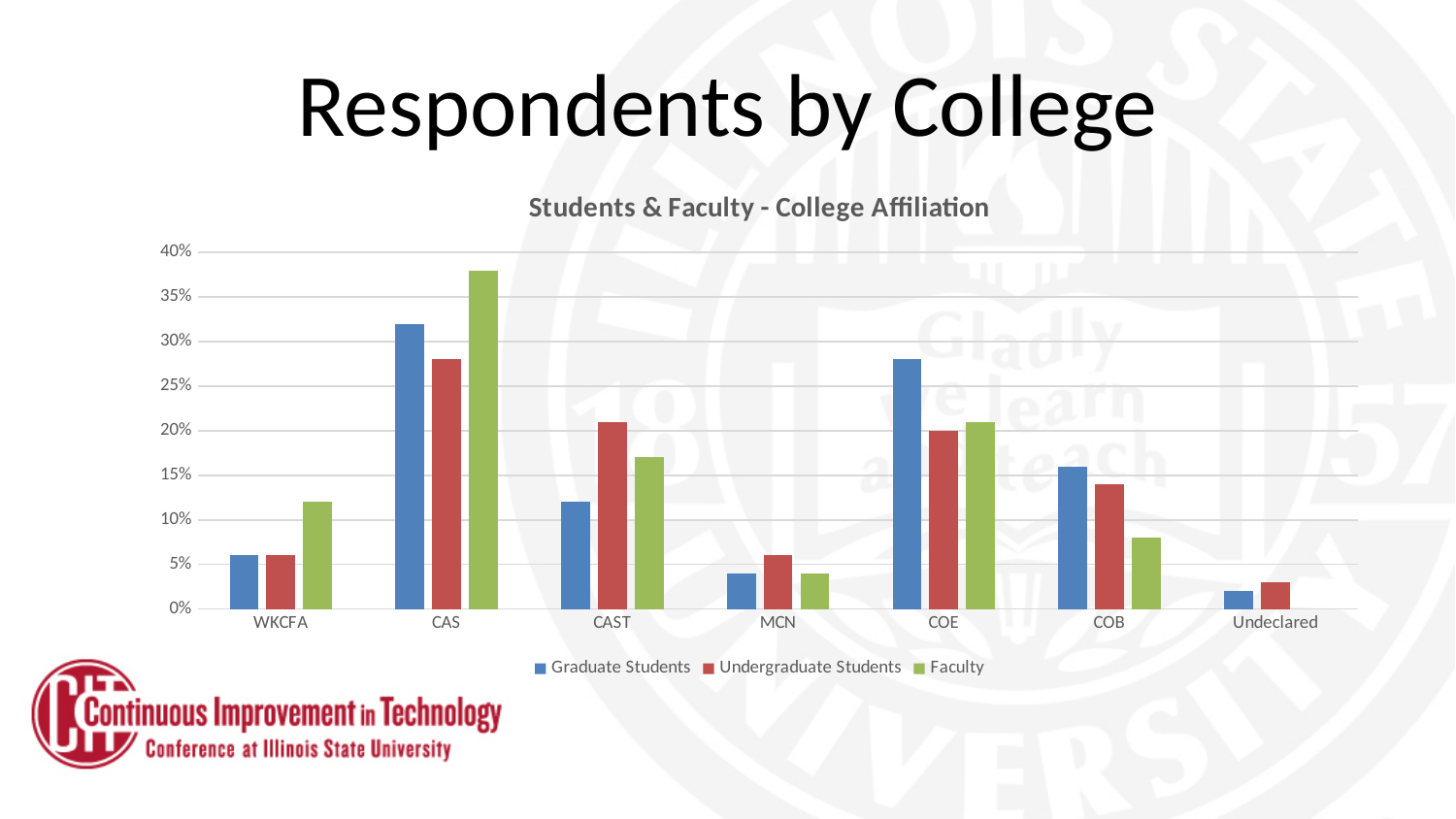
For COE, which is larger: the Graduate Students value or the Faculty value? Graduate Students Which college has the lowest Graduate Students value? Undeclared What kind of chart is shown on the slide? bar chart What is the title of the chart? Students & Faculty - College Affiliation How many college categories are shown on the x axis? 7 Which college has the highest Faculty value? CAS Is the Undergraduate Students value for MCN greater or less than 10%? less Which series is shown in green in the legend? Faculty Is the Graduate Students value for COE greater or less than 25%? greater How many series does the legend list? 3 Is the Faculty value for CAS greater or less than 35%? greater For WKCFA, which is larger: the Faculty value or the Graduate Students value? Faculty